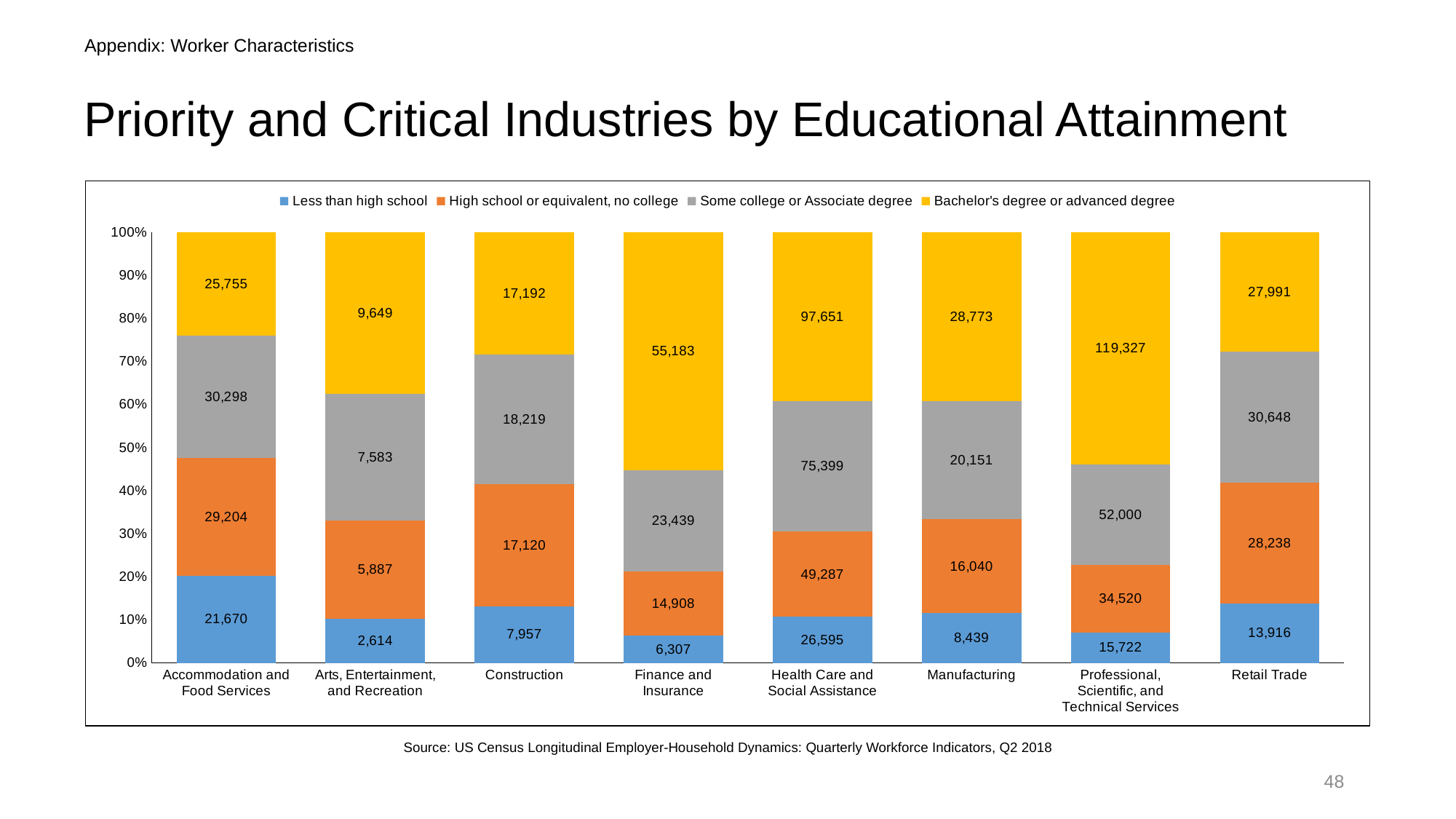
What is the difference between the Bachelor's degree or advanced degree values for Professional, Scientific, and Technical Services and Health Care and Social Assistance? 21,676 What is the value for Bachelor's degree or advanced degree in Professional, Scientific, and Technical Services? 119,327 How many series does the legend list? 4 What is the value for Some college or Associate degree in Finance and Insurance? 23,439 Which industry has the highest value for Bachelor's degree or advanced degree? Professional, Scientific, and Technical Services Which industry has the lowest value for Less than high school? Arts, Entertainment, and Recreation What is the value for Less than high school in Accommodation and Food Services? 21,670 What kind of chart is shown on the slide? Stacked bar chart Which is larger in Retail Trade: the Some college or Associate degree value or the High school or equivalent, no college value? Some college or Associate degree Is the share of the Bachelor's degree or advanced degree segment in Finance and Insurance greater or less than 50%? greater How many industries are shown on the x axis? 8 What is the total of all four education segments for Manufacturing? 73,403